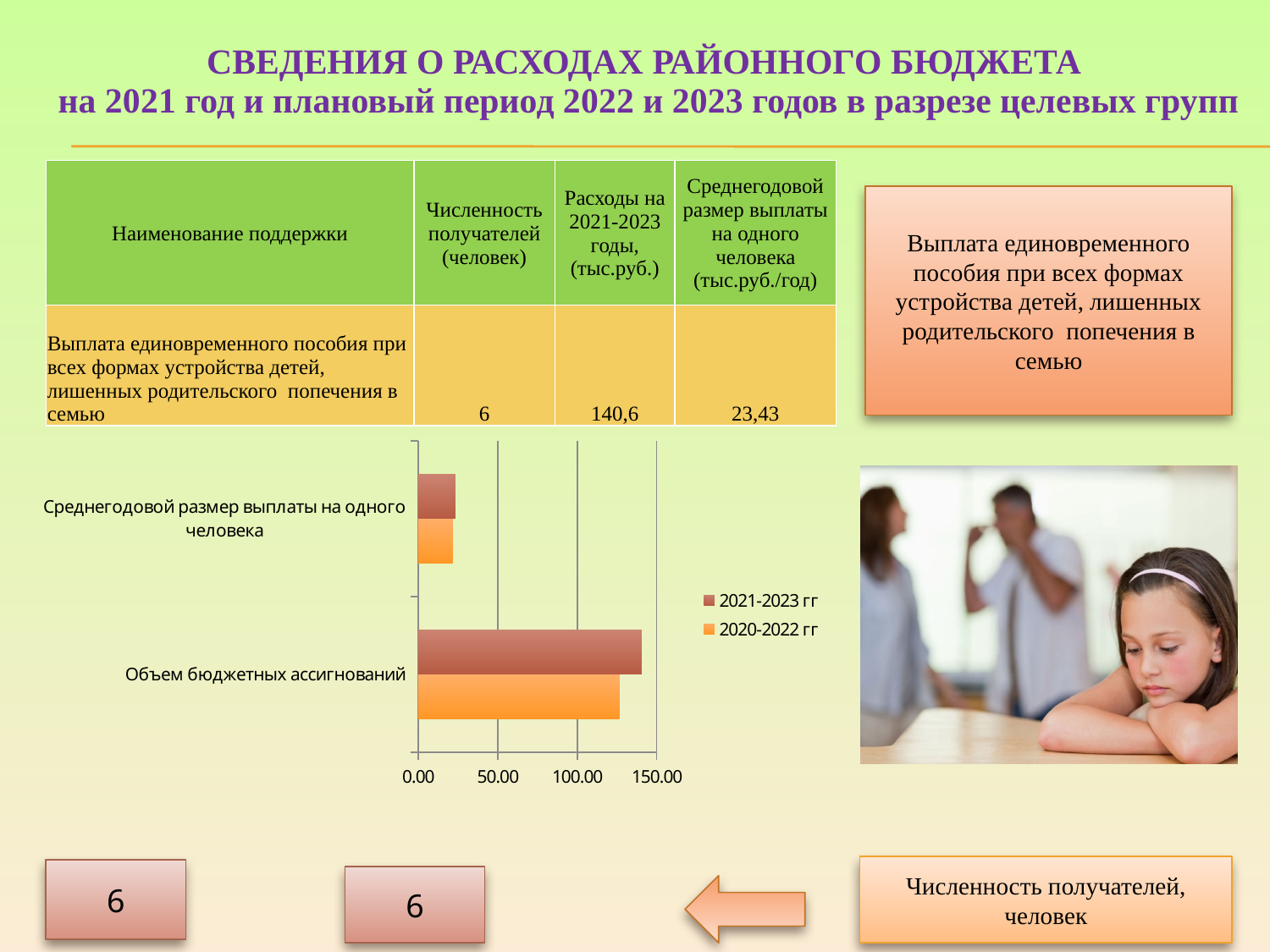
Which category has the lowest value in the 2020-2022 гг series? Среднегодовой размер выплаты на одного человека Is the value for Объем бюджетных ассигнований in the 2021-2023 гг series greater or less than 100.00? greater How many series does the chart legend list? 2 Is the value for Объем бюджетных ассигнований in the 2020-2022 гг series greater or less than 100.00? greater Which colour represents the 2020-2022 гг series in the chart? orange Which category has the highest value in the 2021-2023 гг series? Объем бюджетных ассигнований Is the value for Среднегодовой размер выплаты на одного человека in the 2021-2023 гг series greater or less than 50.00? less How many categories are plotted on the chart? 2 What kind of chart is shown on the slide? bar chart For Объем бюджетных ассигнований, which series has the larger value: 2021-2023 гг or 2020-2022 гг? 2021-2023 гг Which series are listed in the chart legend? 2021-2023 гг and 2020-2022 гг